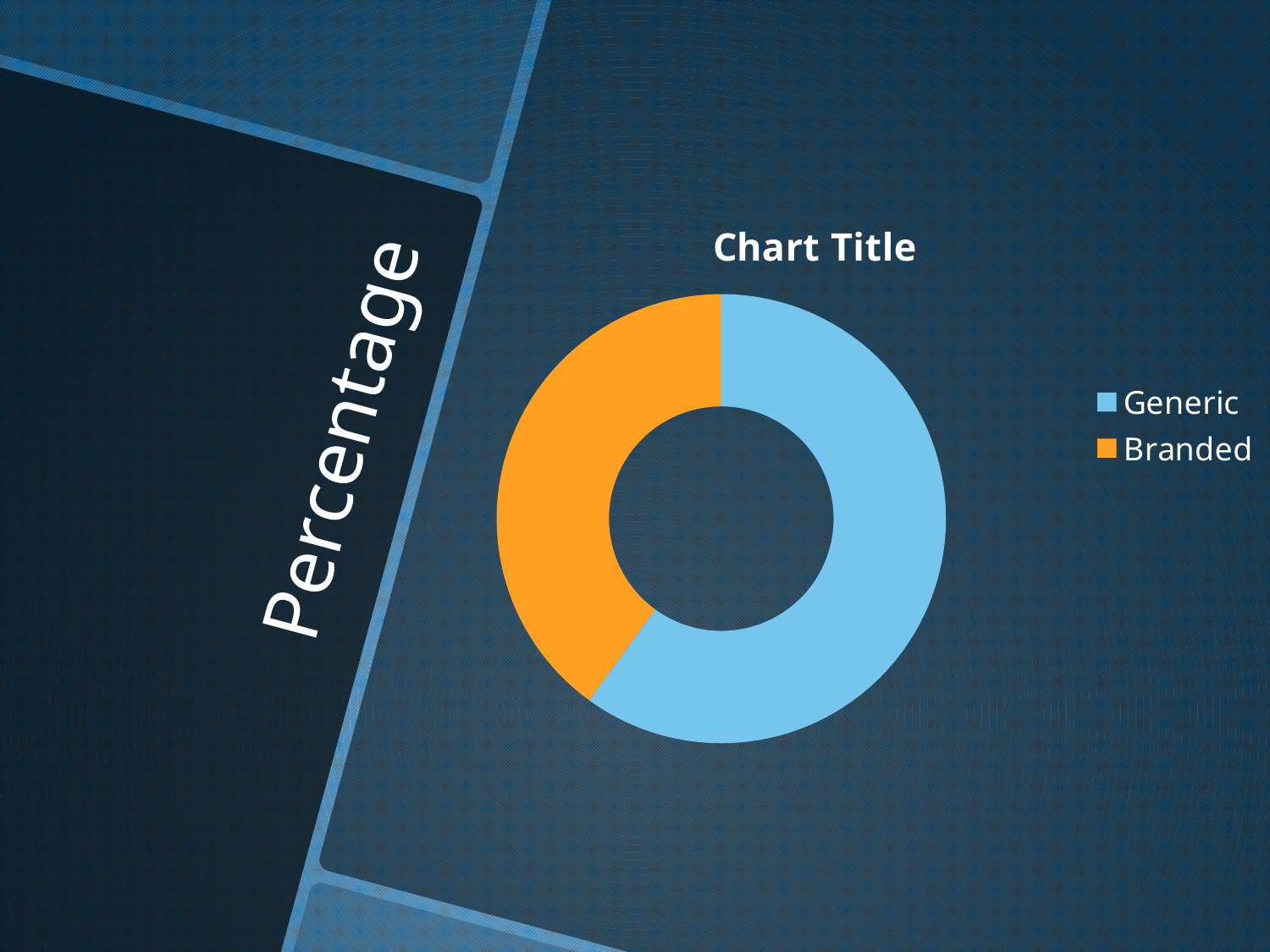
Which is larger, the Generic slice or the Branded slice? Generic Is the Generic share of the doughnut greater or less than 50%? greater What is the title of the chart? Chart Title Which category has the smallest share of the doughnut chart? Branded Which category has the largest share of the doughnut chart? Generic How many categories does the legend list? 2 Is the Branded share of the doughnut greater or less than 50%? less What colour represents Branded in the chart? Orange What kind of chart is shown on the slide? Doughnut chart